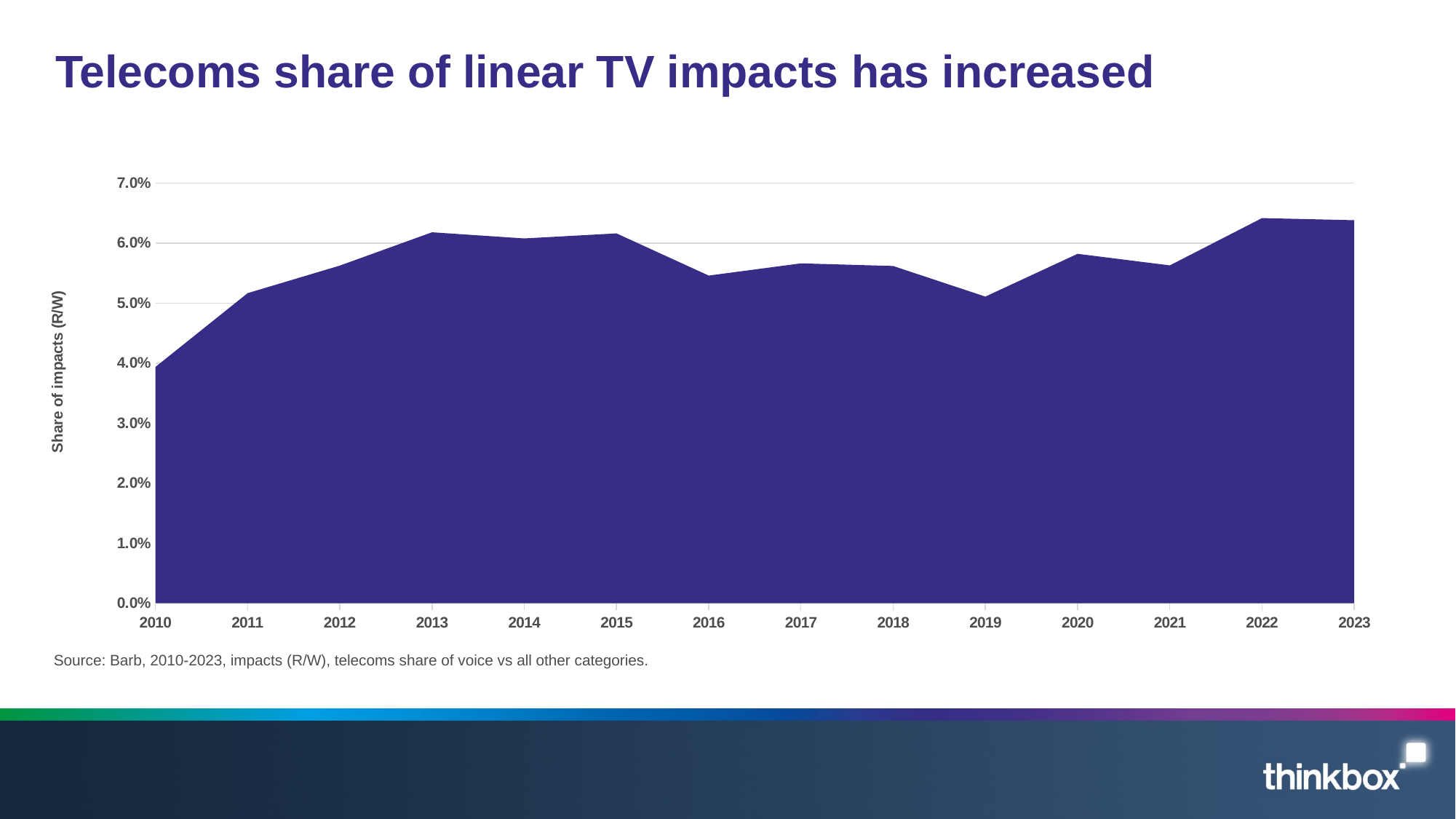
Which year has the lowest share of impacts? 2010 Which is larger, the value for 2010 or the value for 2013? 2013 Is the value for 2010 greater or less than 3.0%? greater How many years are plotted along the x axis? 14 Is the value for 2016 greater or less than 6.0%? less What is the label on the y axis? Share of impacts (R/W) Is the value for 2022 greater or less than 6.0%? greater What kind of chart is shown on the slide? Area chart Overall, does the share of impacts rise or fall from 2010 to 2023? Rise Which is larger, the value for 2019 or the value for 2022? 2022